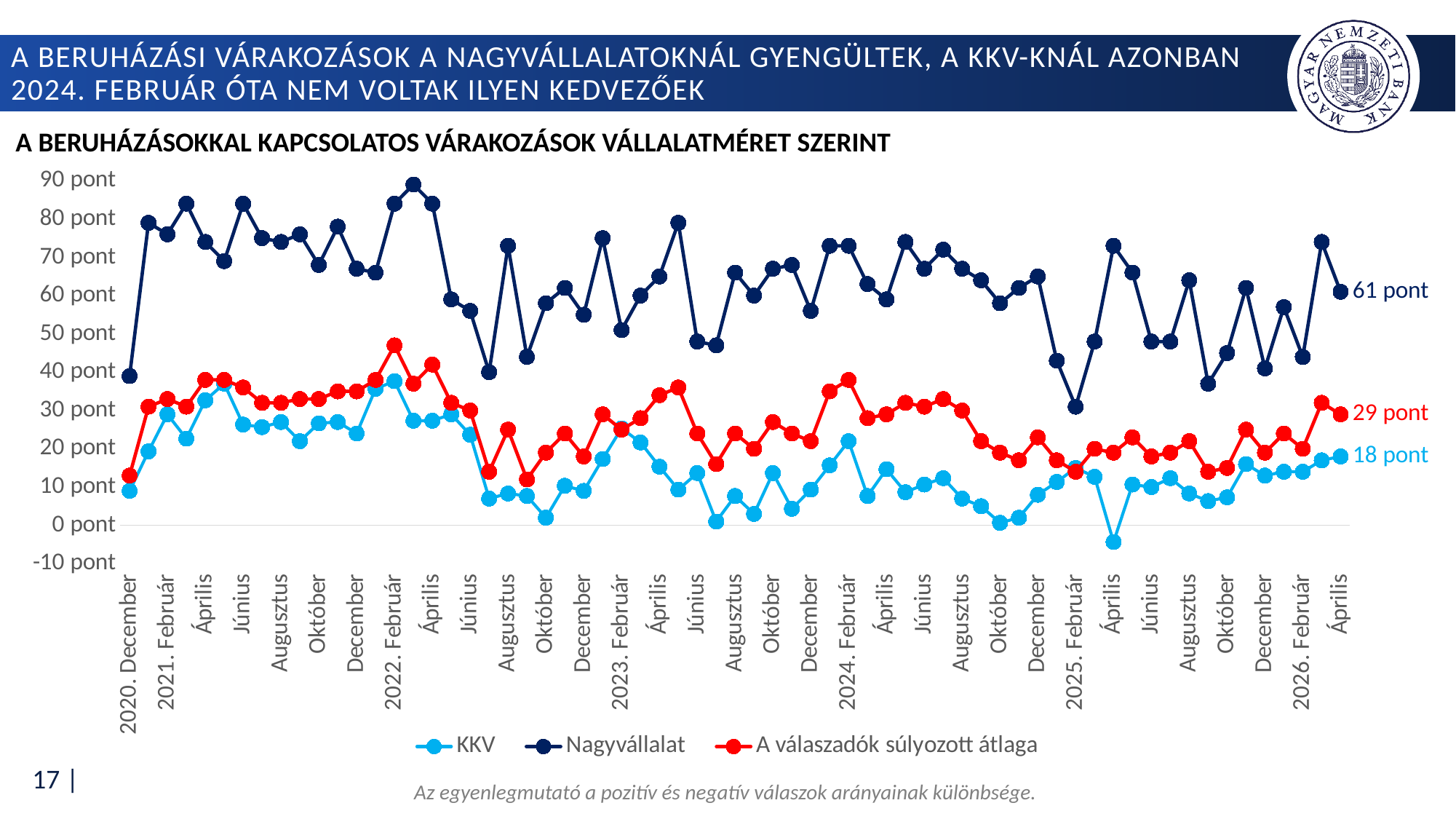
What is the latest value shown for the KKV series? 18 pont What kind of chart is shown on the slide? Line chart Is the KKV value in 2025. Április greater or less than 0 pont? less What is the title of the chart? A BERUHÁZÁSOKKAL KAPCSOLATOS VÁRAKOZÁSOK VÁLLALATMÉRET SZERINT How many series does the legend list? 3 What is the latest value shown for the 'A válaszadók súlyozott átlaga' series? 29 pont What is the difference between the latest Nagyvállalat value and the latest KKV value? 43 pont What is the difference between the latest 'A válaszadók súlyozott átlaga' value and the latest KKV value? 11 pont At the last point (2026. Április), which series has the higher value: KKV or Nagyvállalat? Nagyvállalat Is the Nagyvállalat value in 2022. Február greater or less than 80 pont? greater What is the latest value shown for the Nagyvállalat series? 61 pont Which series has the lowest value at the last point (2026. Április)? KKV